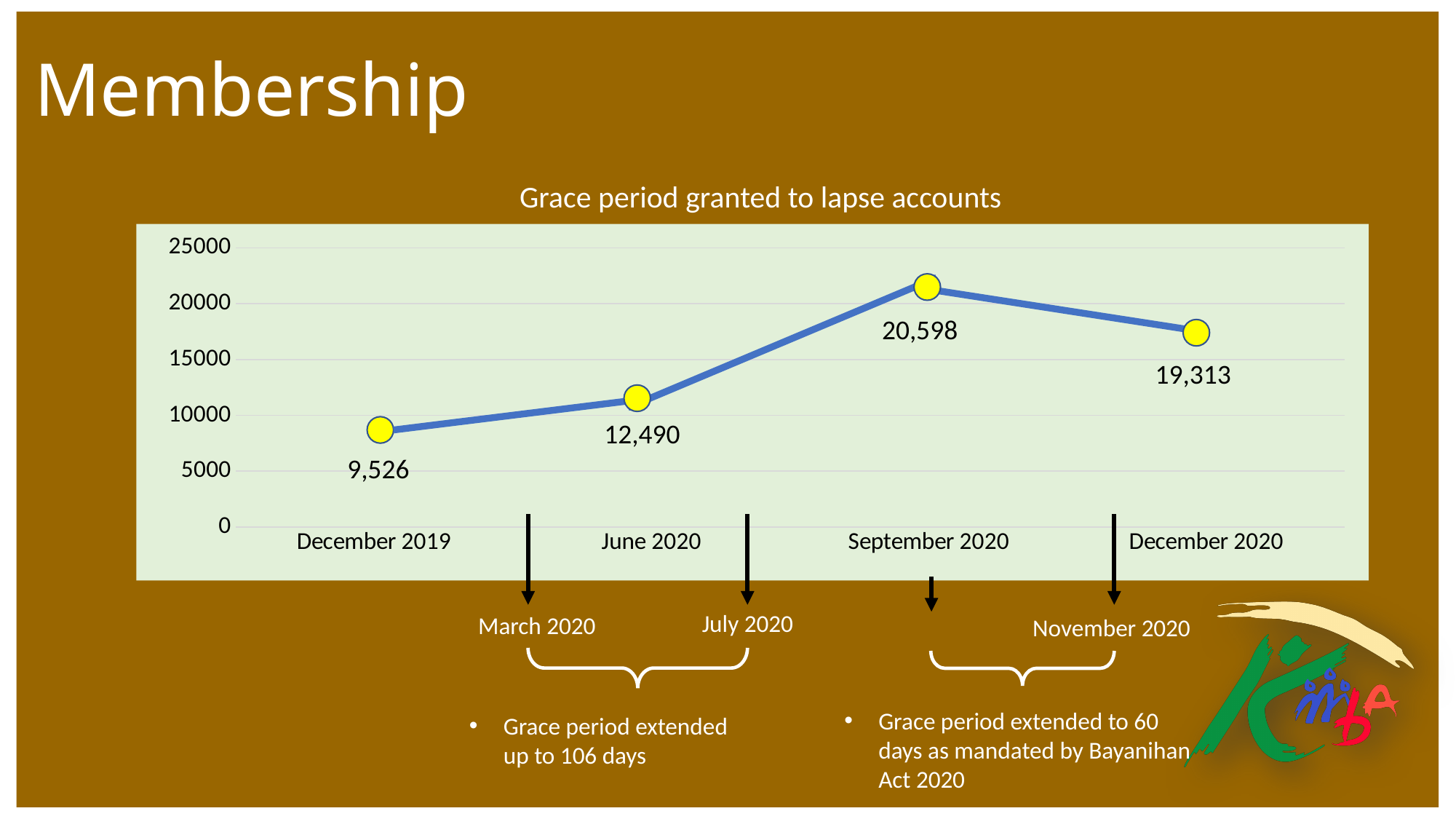
What is the difference between the values for September 2020 and June 2020? 8,108 Which period has the lowest value? December 2019 How many data points are plotted on the chart? 4 Which period has the highest value? September 2020 What is the title of the chart? Grace period granted to lapse accounts Which is larger, the value for September 2020 or December 2020? September 2020 What is the difference between the values for December 2020 and December 2019? 9,787 What is the value for December 2019? 9,526 What is the value for September 2020? 20,598 What is the value for June 2020? 12,490 What is the value for December 2020? 19,313 What kind of chart is shown on the slide? Line chart